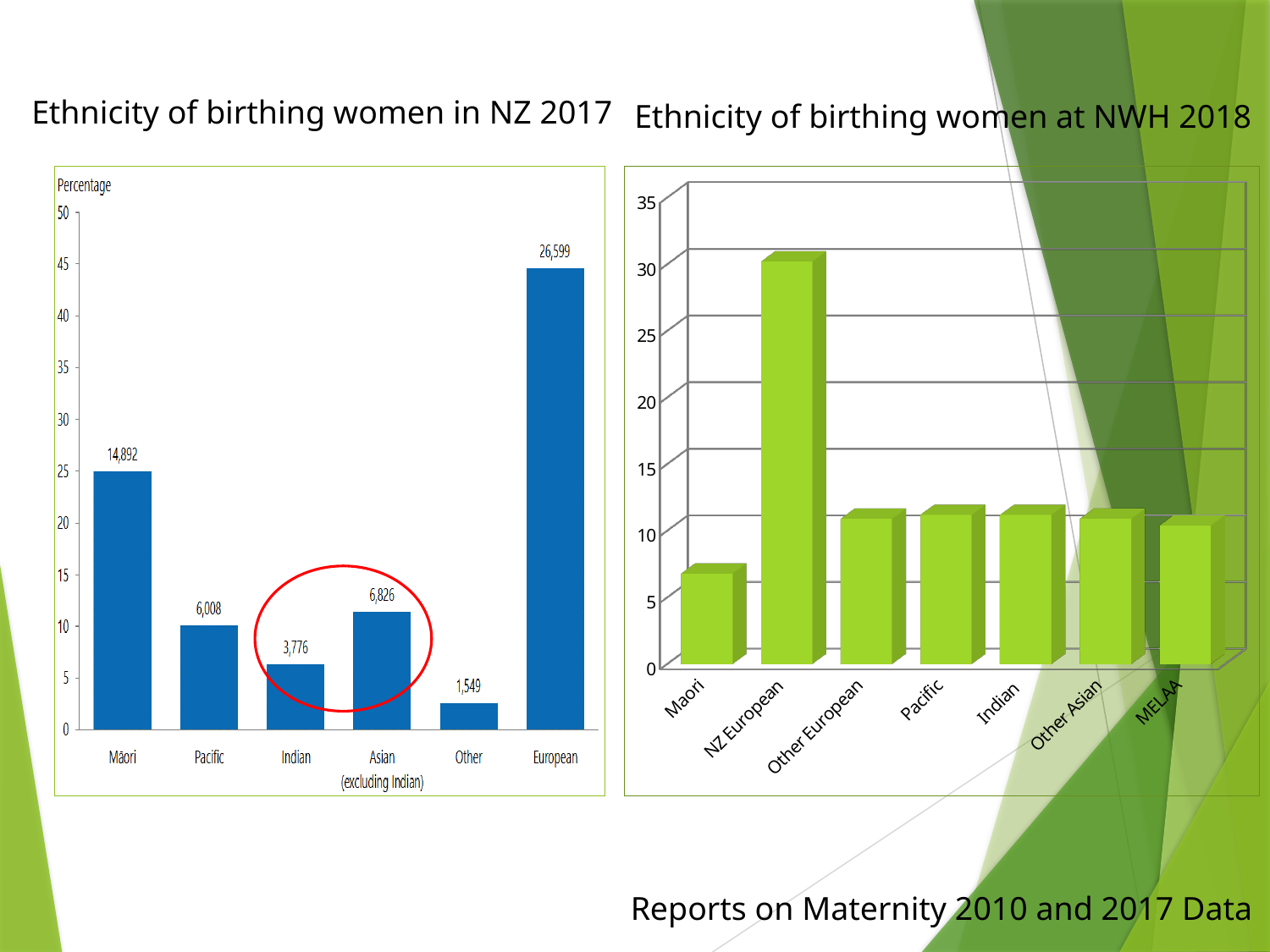
In the chart 'Ethnicity of birthing women in NZ 2017', what is the data label shown for European? 26,599 How many categories are shown in the chart 'Ethnicity of birthing women in NZ 2017'? 6 How many categories are shown in the chart 'Ethnicity of birthing women at NWH 2018'? 7 In the chart 'Ethnicity of birthing women in NZ 2017', what is the data label shown for Māori? 14,892 In the chart 'Ethnicity of birthing women in NZ 2017', what is the data label shown for Indian? 3,776 In the chart 'Ethnicity of birthing women in NZ 2017', what is the difference between the data labels for Asian (excluding Indian) and Indian? 3,050 In the chart 'Ethnicity of birthing women at NWH 2018', is the value for NZ European greater or less than 25? greater In the chart 'Ethnicity of birthing women in NZ 2017', which category has the lowest bar? Other In the chart 'Ethnicity of birthing women at NWH 2018', which category has the lowest bar? Maori In the chart 'Ethnicity of birthing women in NZ 2017', which has the larger data label, Pacific or Asian (excluding Indian)? Asian (excluding Indian) In the chart 'Ethnicity of birthing women at NWH 2018', which category has the highest bar? NZ European In the chart 'Ethnicity of birthing women in NZ 2017', which category has the highest bar? European